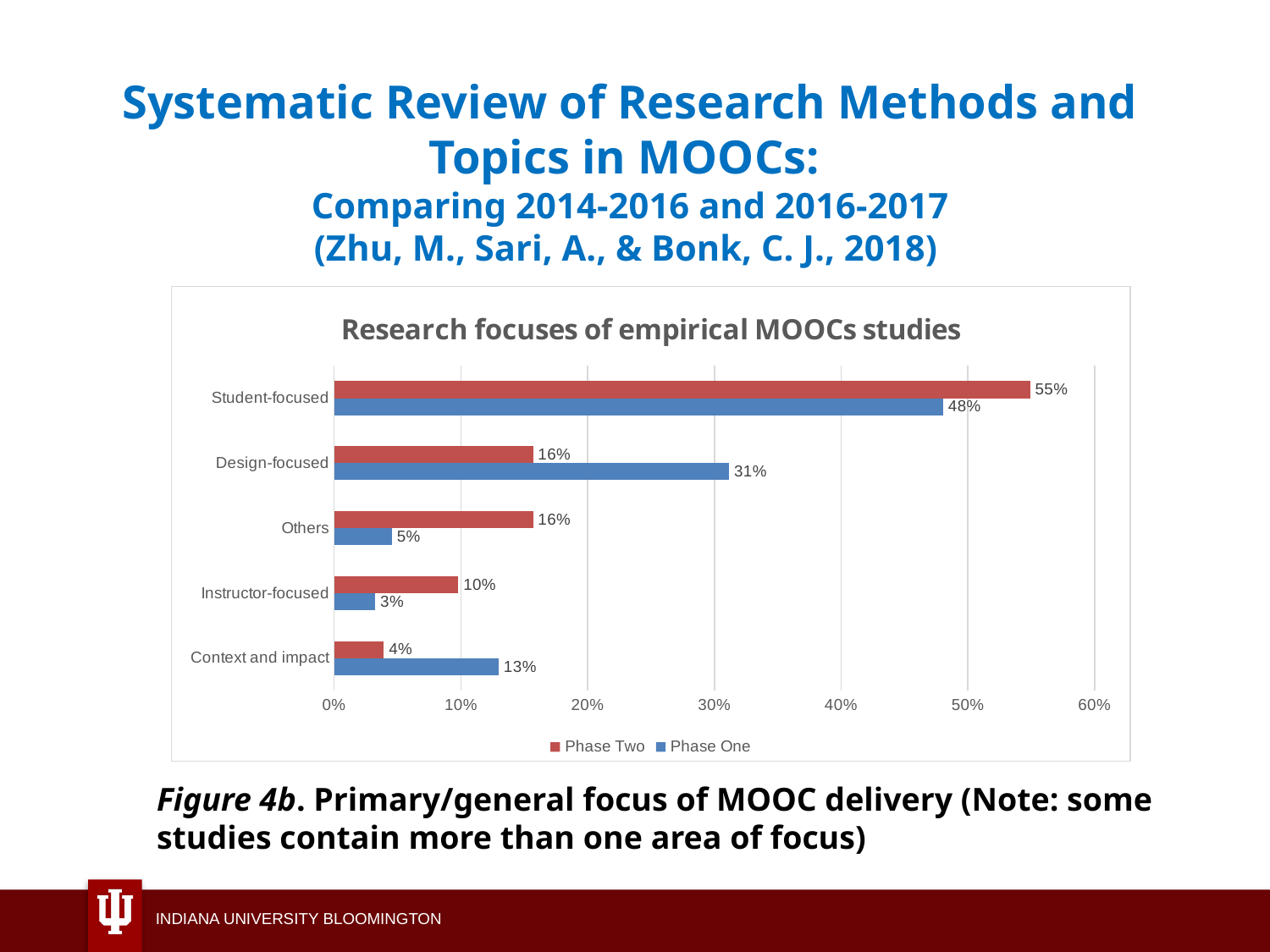
How many categories are shown on the chart? 5 Is the Phase One value for Student-focused greater or less than 40%? greater Which category has the highest Phase One value? Student-focused What is the Phase Two value for Student-focused? 55% What is the Phase One value for Context and impact? 13% What is the difference between the Phase Two and Phase One values for Design-focused? 15% What is the title of the chart? Research focuses of empirical MOOCs studies What is the Phase One value for Design-focused? 31% Which is larger for Others: the Phase One value or the Phase Two value? Phase Two Which category has the lowest Phase Two value? Context and impact How many series does the legend list? 2 What kind of chart is shown on the slide? Bar chart